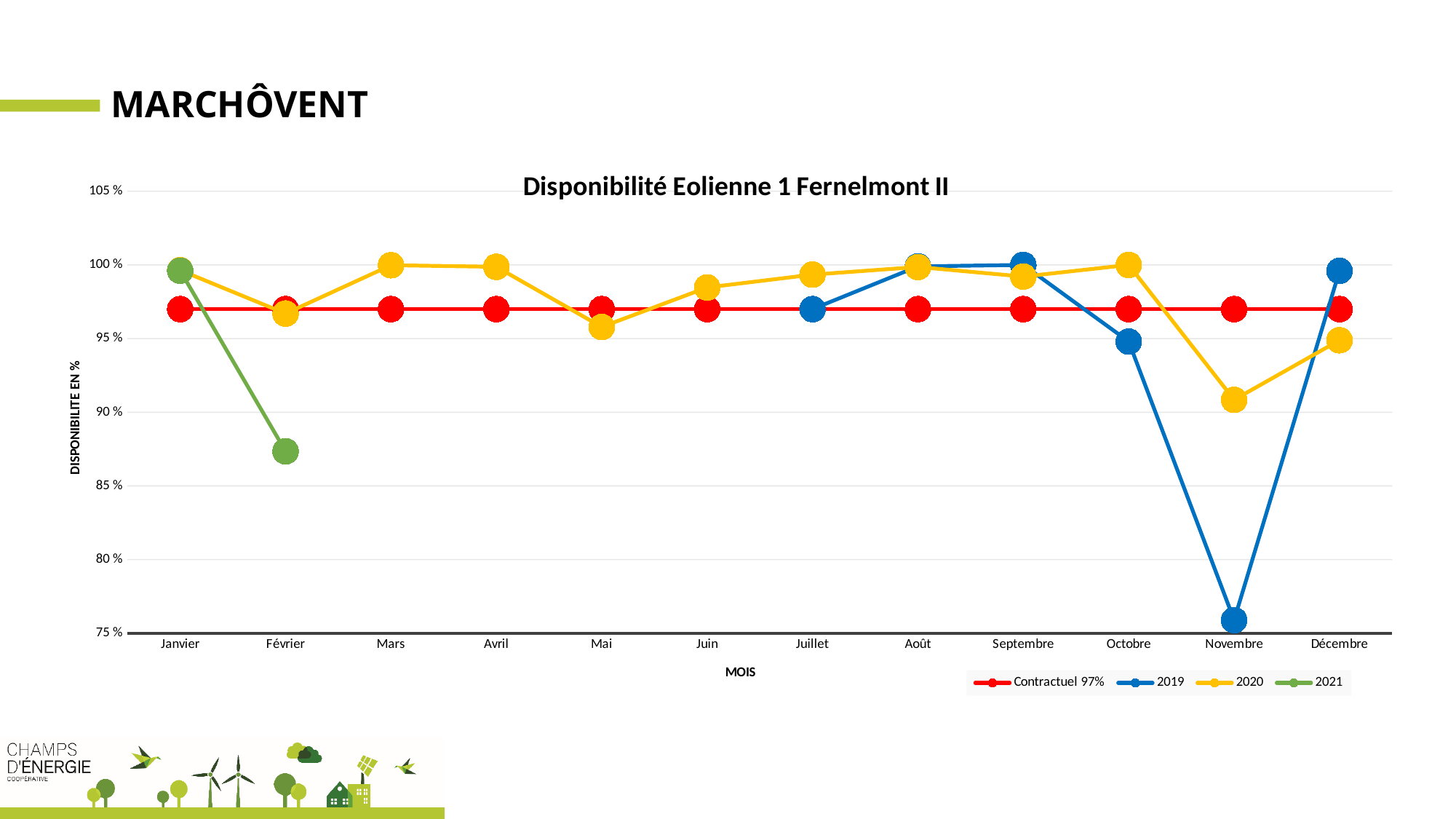
Is the value for 2019 in Décembre greater or less than 95 %? greater In which month does the 2019 series reach its lowest value? Novembre In Novembre, which series has the larger value, 2019 or 2020? 2020 What is the value of the Contractuel line, as given in the legend? 97% How many series does the legend list? 4 What is the title of the chart? Disponibilité Eolienne 1 Fernelmont II Is the value for 2021 in Février greater or less than 90 %? less What kind of chart is shown on the slide? line chart In which month does the 2020 series reach its lowest value? Novembre Does the 2021 series rise or fall from Janvier to Février? fall Is the value for 2019 in Novembre greater or less than 80 %? less How many months are shown on the x axis? 12